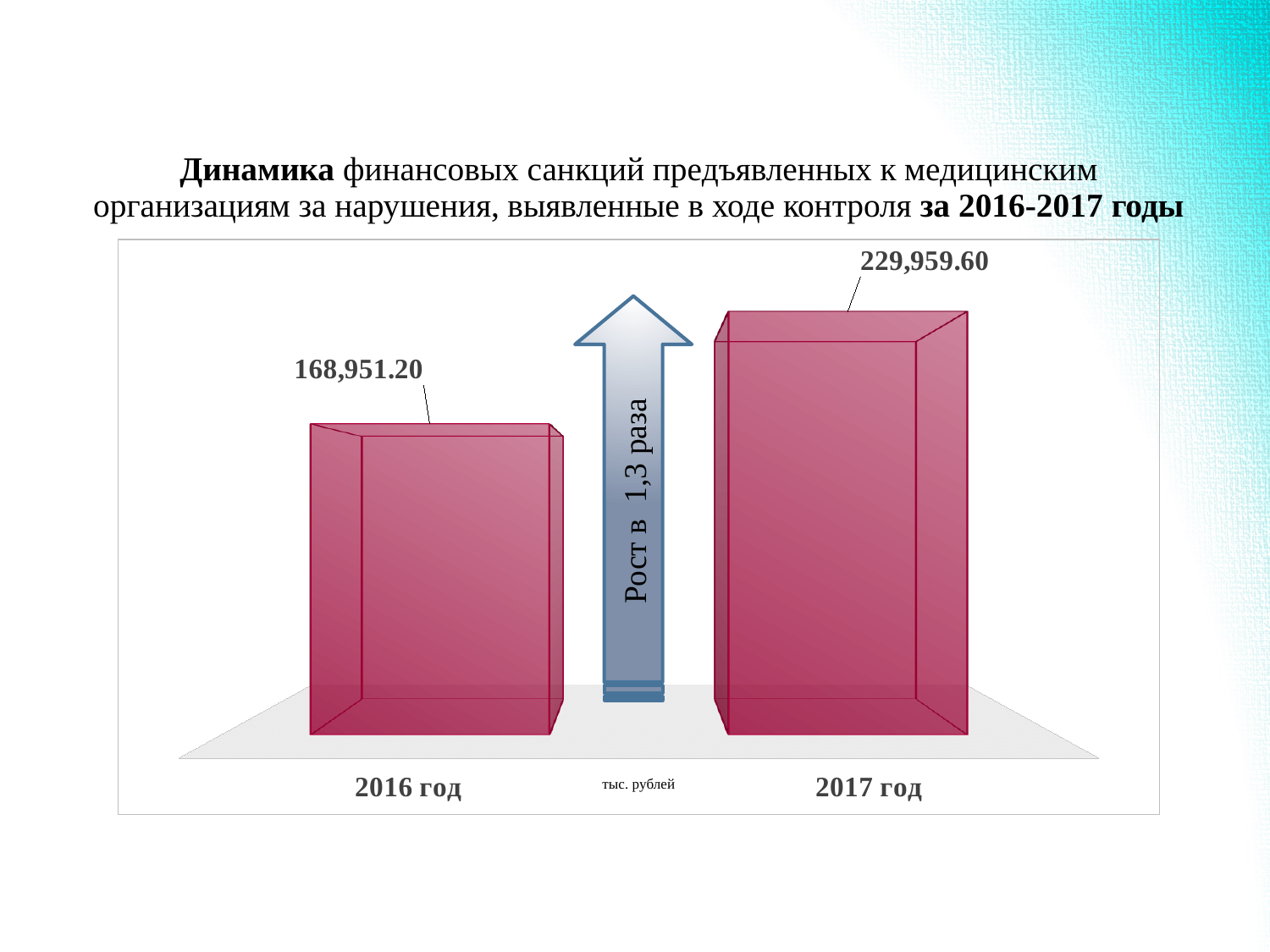
Which year has the highest value? 2017 год Which is larger, the value for 2016 год or the value for 2017 год? 2017 год What is the value for 2016 год? 168,951.20 How many categories (years) are shown in the chart? 2 What is the value for 2017 год? 229,959.60 What kind of chart is shown on the slide? Bar chart What growth factor is written on the arrow between the two bars? Рост в 1,3 раза What unit of measurement is indicated below the chart? тыс. рублей Which year has the lowest value? 2016 год Do the values rise or fall from 2016 год to 2017 год? Rise What is the difference between the values for 2017 год and 2016 год? 61,008.40